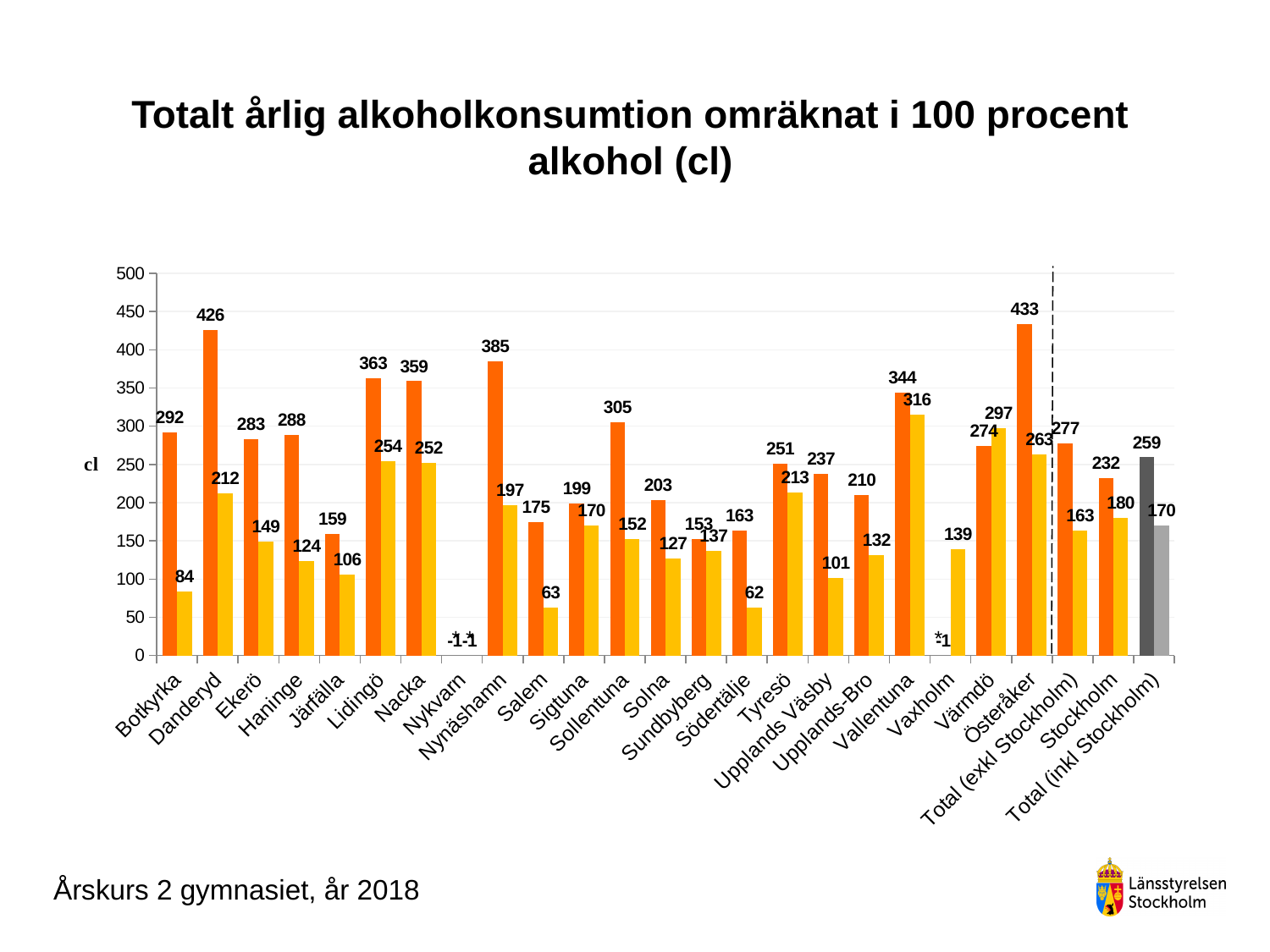
What is the value of the yellow bar for Vallentuna? 316 What is the difference between the orange and yellow bars for Botkyrka? 208 Which is larger for Värmdö, the orange bar or the yellow bar? the yellow bar Is the orange bar for Nynäshamn greater or less than 350? greater How many categories are shown on the x axis? 25 What is the value of the dark grey bar for Total (inkl Stockholm)? 259 Which municipality has the highest orange bar? Österåker What is the title of the chart? Totalt årlig alkoholkonsumtion omräknat i 100 procent alkohol (cl) Which municipality has the highest yellow bar? Vallentuna What is the value of the orange bar for Danderyd? 426 What is the label on the y axis? cl What kind of chart is shown on the slide? bar chart